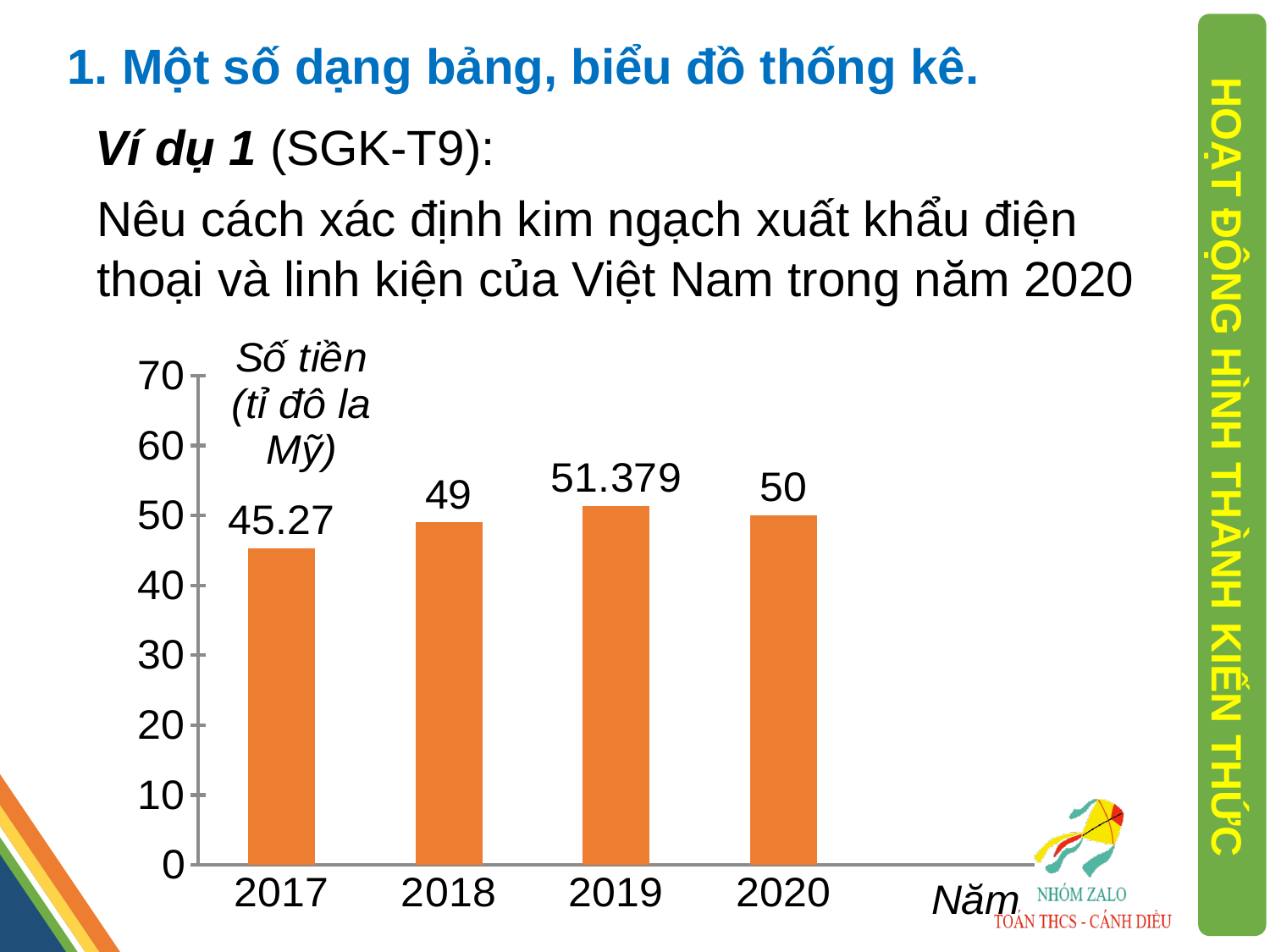
What is the value for 2019? 51.379 What kind of chart is shown on the slide? bar chart What is the value for 2020? 50 Which year has the lowest value? 2017 What is the value for 2017? 45.27 What is the difference between the values for 2019 and 2020? 1.379 What is the difference between the values for 2018 and 2017? 3.73 How many years are shown on the x axis? 4 Is the value for 2017 greater or less than 40? greater Which is larger, the value for 2018 or the value for 2020? 2020 What is the label of the vertical axis? Số tiền (tỉ đô la Mỹ) Which year has the highest value? 2019